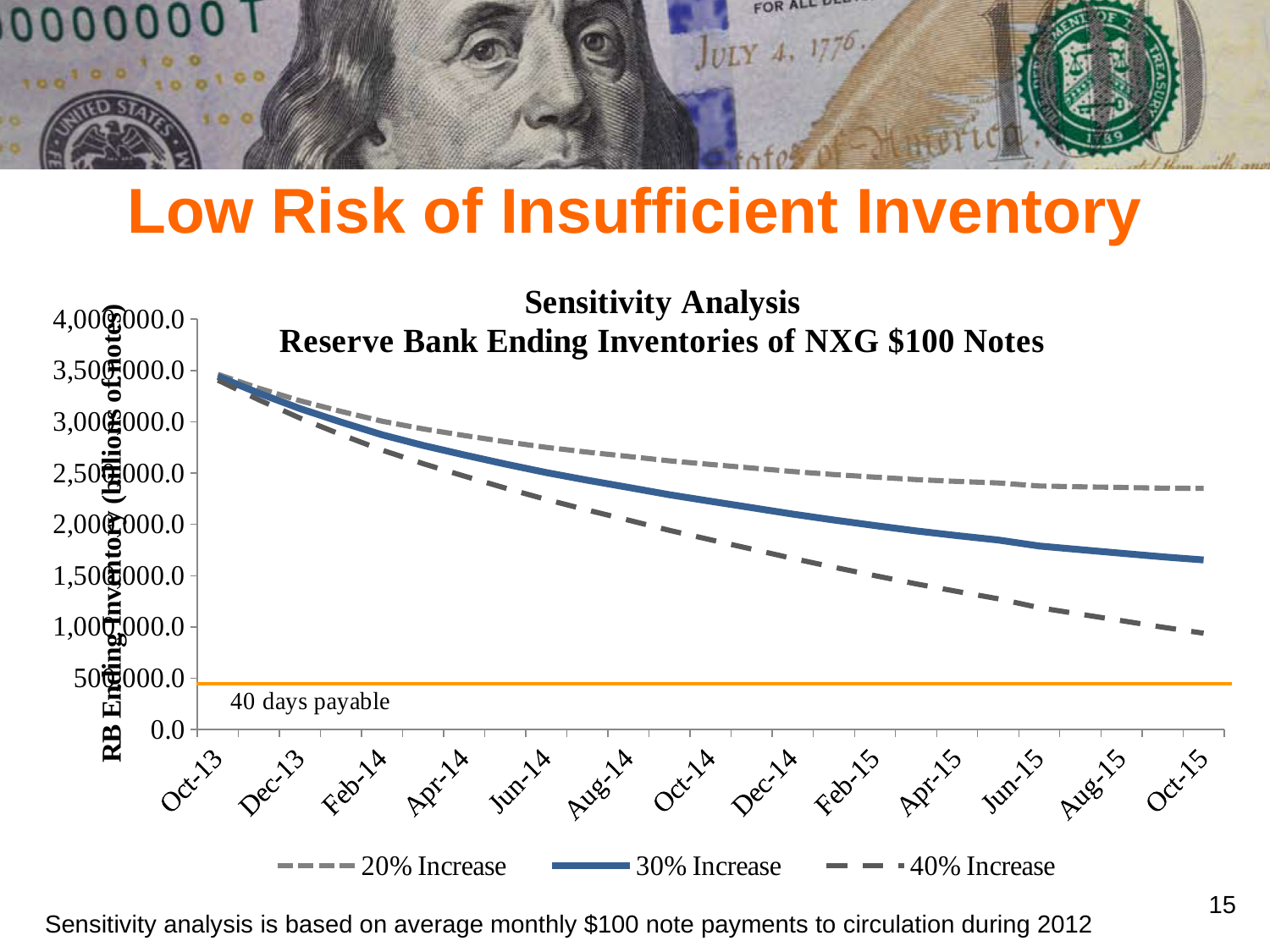
Is the value for the 40% Increase series at Oct-15 greater or less than 1,500,000.0? less Which series does the legend show with a solid blue line? 30% Increase How many series does the legend list? 3 Which series has the highest value at Oct-15? 20% Increase What is the title of the chart? Sensitivity Analysis Reserve Bank Ending Inventories of NXG $100 Notes Is the value for the 20% Increase series at Oct-15 greater or less than 2,000,000.0? greater How many date labels are shown on the x axis? 13 Is the value for the 30% Increase series at Oct-15 greater or less than 1,500,000.0? greater What kind of chart is shown on the slide? line chart Do the values for the 30% Increase series rise or fall from Oct-13 to Oct-15? fall At Oct-15, which is larger: the 20% Increase value or the 40% Increase value? 20% Increase Which series has the lowest value at Oct-15? 40% Increase